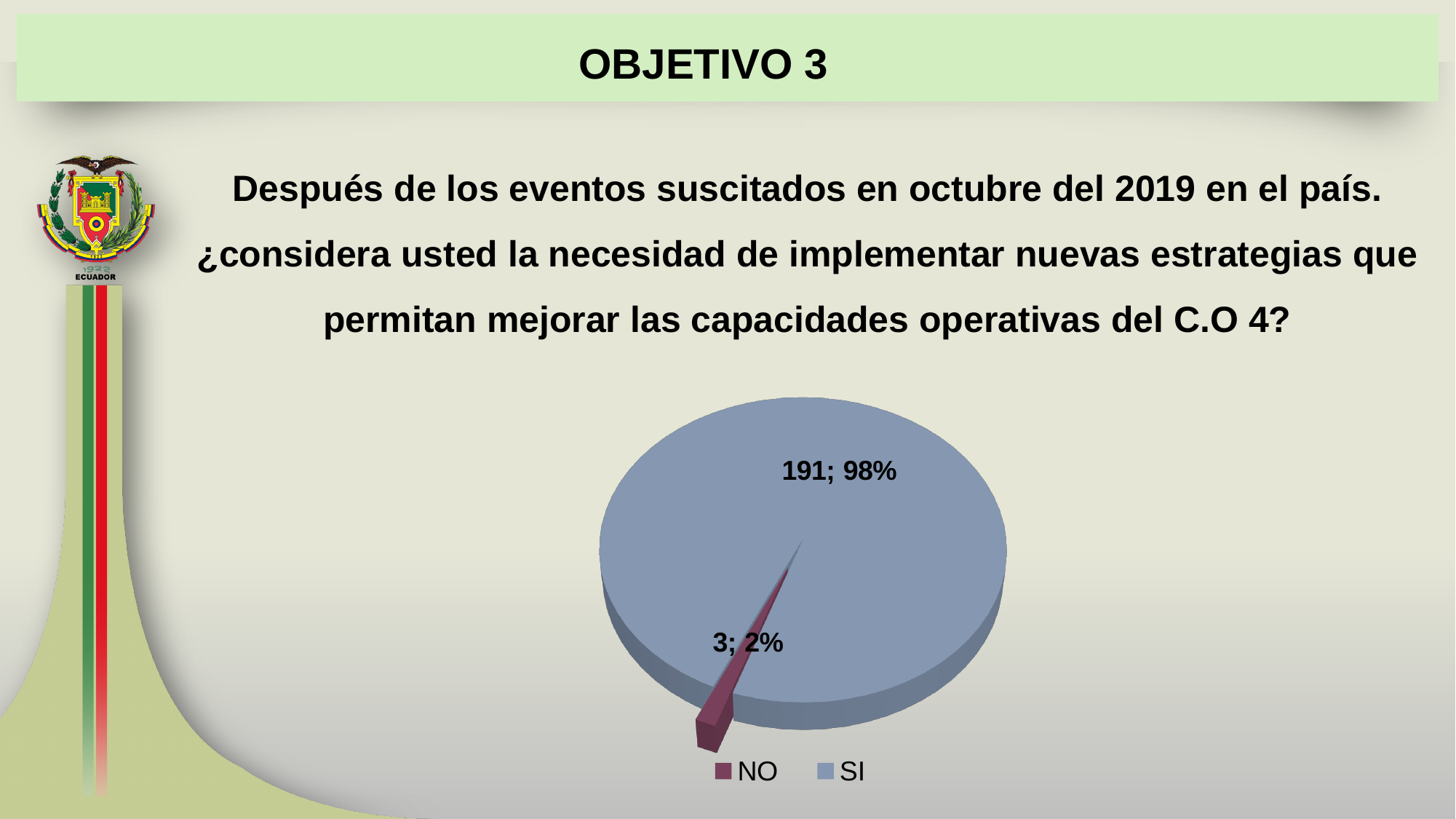
How many respondents answered SI? 191 How many categories does the pie chart show? 2 What colour is the SI slice in the pie chart? blue-grey Which is larger, the count for SI or the count for NO? SI What is the difference between the number of SI and NO responses? 188 What kind of chart is shown on the slide? pie chart What percentage of the pie does the NO slice represent? 2% Which category has the smallest slice of the pie? NO How many respondents answered NO? 3 What is the total number of responses shown in the pie chart? 194 Which category has the largest slice of the pie? SI What percentage of the pie does the SI slice represent? 98%